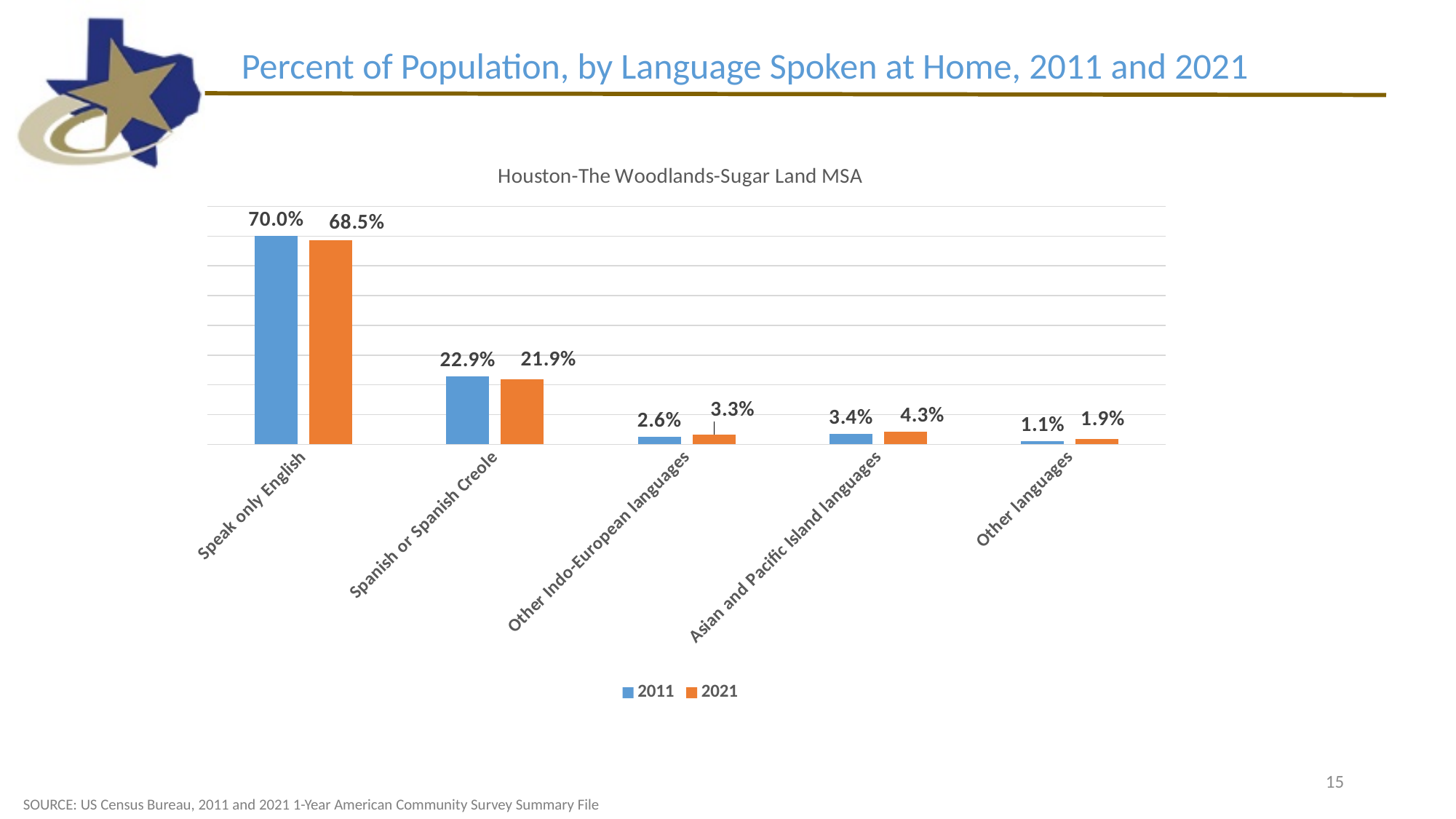
What is the 2021 value for Spanish or Spanish Creole? 21.9% What is the 2021 value for Asian and Pacific Island languages? 4.3% How many language categories are shown on the x axis? 5 How many series does the legend list? 2 Which language category has the lowest value in 2011? Other languages Which is larger for Asian and Pacific Island languages, the 2011 value or the 2021 value? 2021 By how many percentage points did the Speak only English share change from 2011 to 2021? 1.5% What is the 2011 value for Other languages? 1.1% What is the difference between the 2021 and 2011 values for Other Indo-European languages? 0.7% What type of chart is shown on the slide? Bar chart What percent of the population spoke only English at home in 2011? 70.0% Which language category has the highest value in 2021? Speak only English